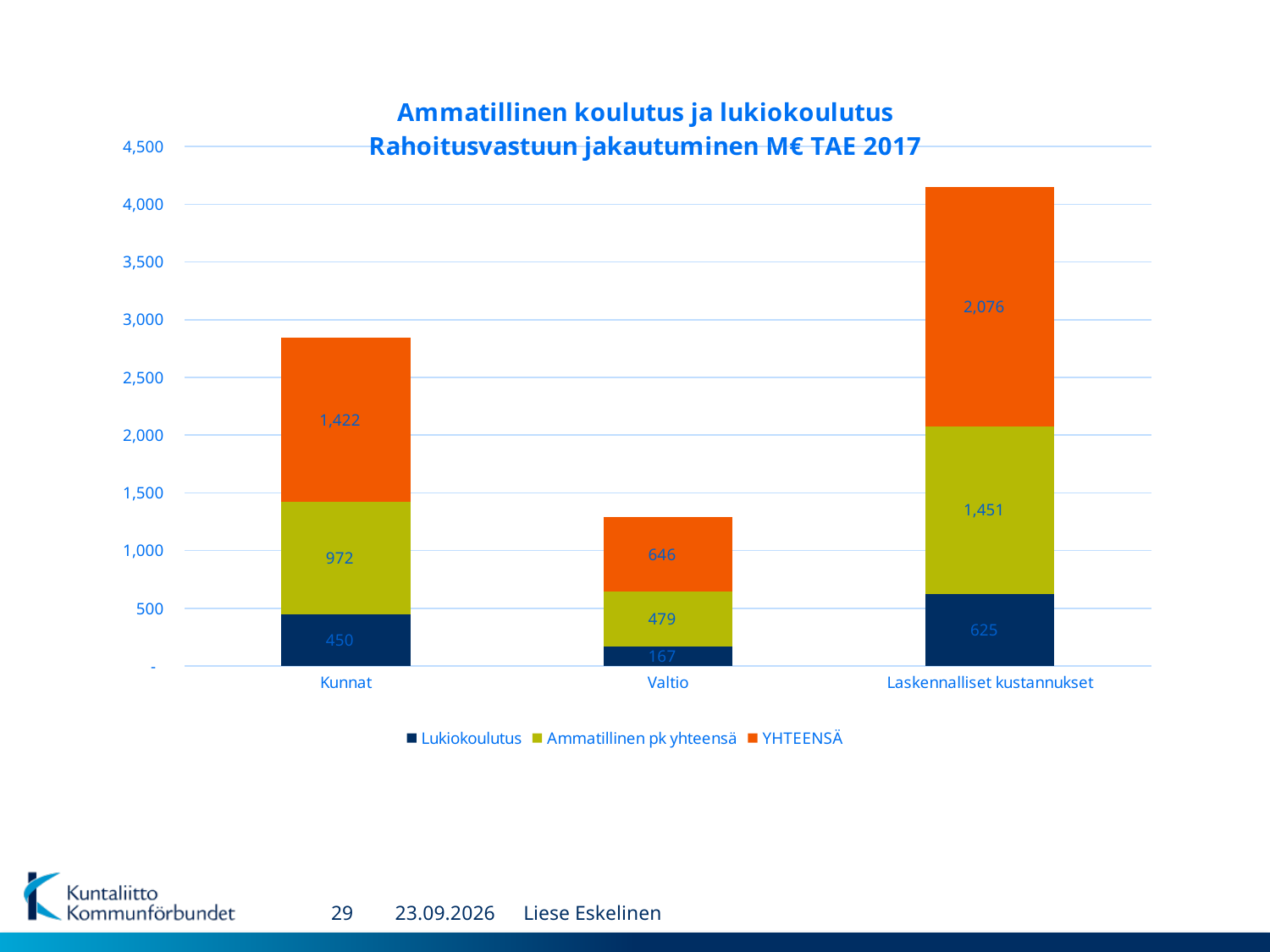
What is the Ammatillinen pk yhteensä value for Valtio? 479 Which is larger: the Lukiokoulutus value for Laskennalliset kustannukset or the Lukiokoulutus value for Kunnat? Laskennalliset kustannukset What is the difference between the YHTEENSÄ values for Kunnat and Valtio? 776 What is the Lukiokoulutus value for Kunnat? 450 What is the Lukiokoulutus value for Valtio? 167 Which category has the lowest Ammatillinen pk yhteensä value? Valtio What is the total of the stacked bar for Valtio? 1,292 Which category has the highest YHTEENSÄ value? Laskennalliset kustannukset What is the YHTEENSÄ value for Laskennalliset kustannukset? 2,076 What type of chart is shown on the slide? Stacked bar chart How many categories are shown on the x axis? 3 How many series does the legend list? 3